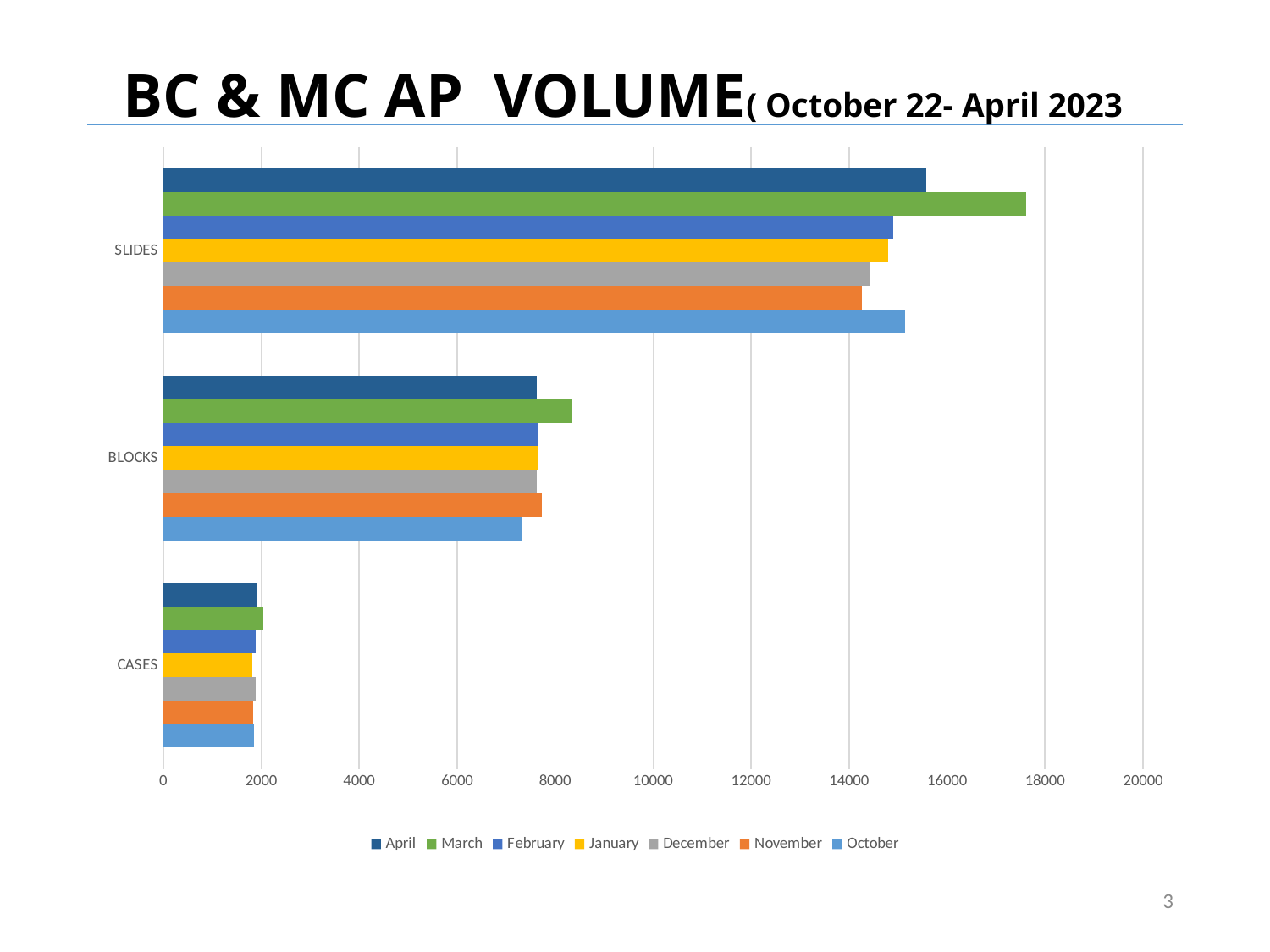
How many categories are shown on the vertical axis of the chart? 3 Is the value for October in BLOCKS greater or less than 8000? less What kind of chart is shown on the slide? bar chart Which month has the highest value for SLIDES? March What is the title of the chart on the slide? BC & MC AP VOLUME( October 22- April 2023 Is the value for March in SLIDES greater or less than 16000? greater Is the value for January in CASES greater or less than 2000? less Which category has the lowest values overall? CASES For SLIDES, which is larger: the value for April or the value for February? April Which month has the highest value for BLOCKS? March Which month has the lowest value for BLOCKS? October How many series does the legend list? 7